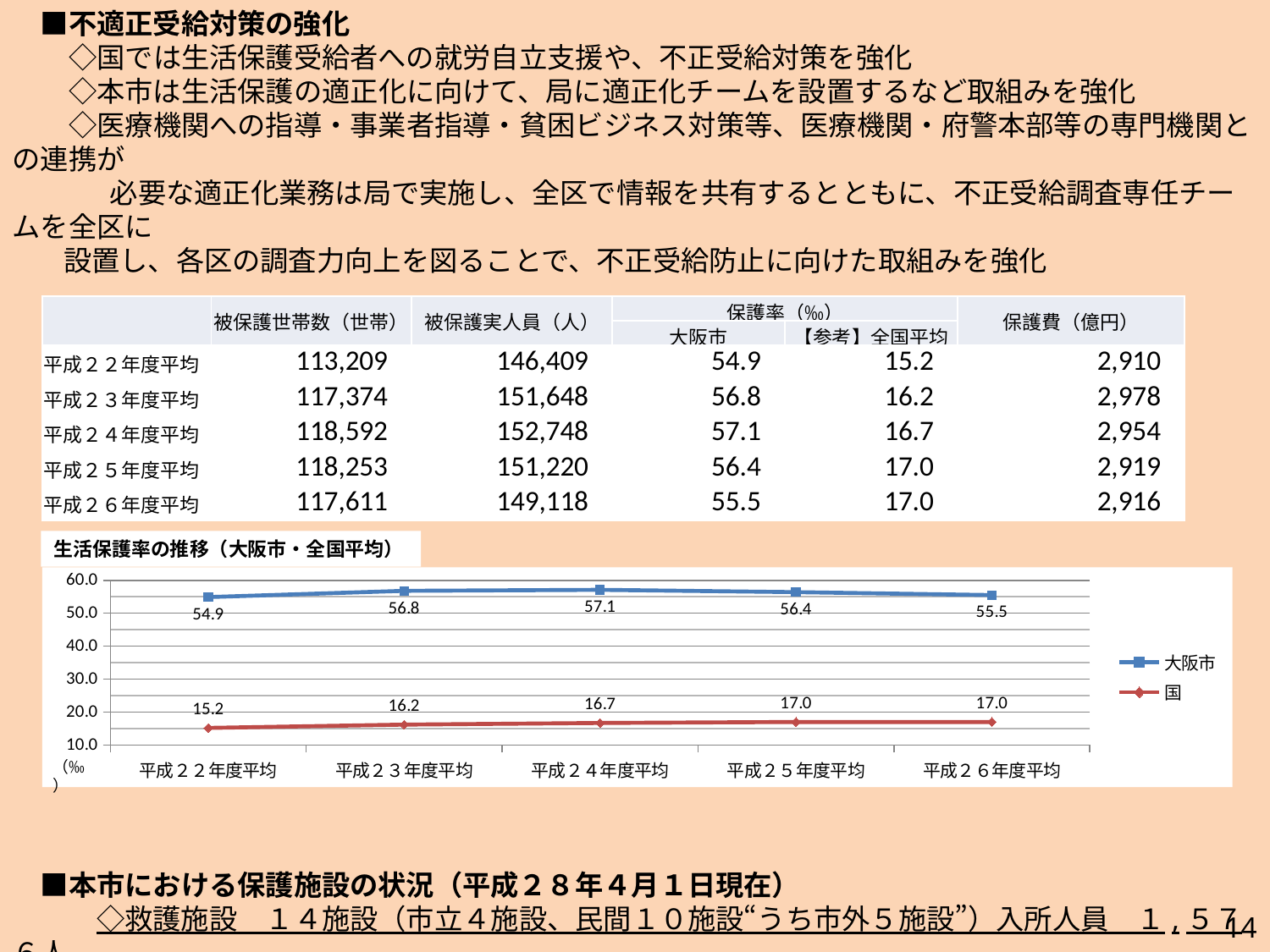
In the chart 生活保護率の推移（大阪市・全国平均）, what is the value for 大阪市 in 平成２６年度平均? 55.5 In the chart 生活保護率の推移（大阪市・全国平均）, what is the value for 国 in 平成２２年度平均? 15.2 What type of chart is shown under the title 生活保護率の推移（大阪市・全国平均）? line chart In the chart 生活保護率の推移（大阪市・全国平均）, in which year is the 大阪市 value highest? 平成２４年度平均 In the chart 生活保護率の推移（大阪市・全国平均）, what is the difference between the 大阪市 and 国 values in 平成２３年度平均? 40.6 How many series does the legend of the chart 生活保護率の推移（大阪市・全国平均） list? 2 In the chart 生活保護率の推移（大阪市・全国平均）, which is larger: the 大阪市 value in 平成２２年度平均 or in 平成２５年度平均? 平成２５年度平均 In the chart 生活保護率の推移（大阪市・全国平均）, in which year is the 国 value lowest? 平成２２年度平均 In the chart 生活保護率の推移（大阪市・全国平均）, what is the value for 大阪市 in 平成２４年度平均? 57.1 In the chart 生活保護率の推移（大阪市・全国平均）, does the 国 series rise or fall from 平成２２年度平均 to 平成２５年度平均? rise In the chart 生活保護率の推移（大阪市・全国平均）, is the 国 value in 平成２６年度平均 greater or less than 20.0? less How many years are plotted along the x axis of the chart 生活保護率の推移（大阪市・全国平均）? 5